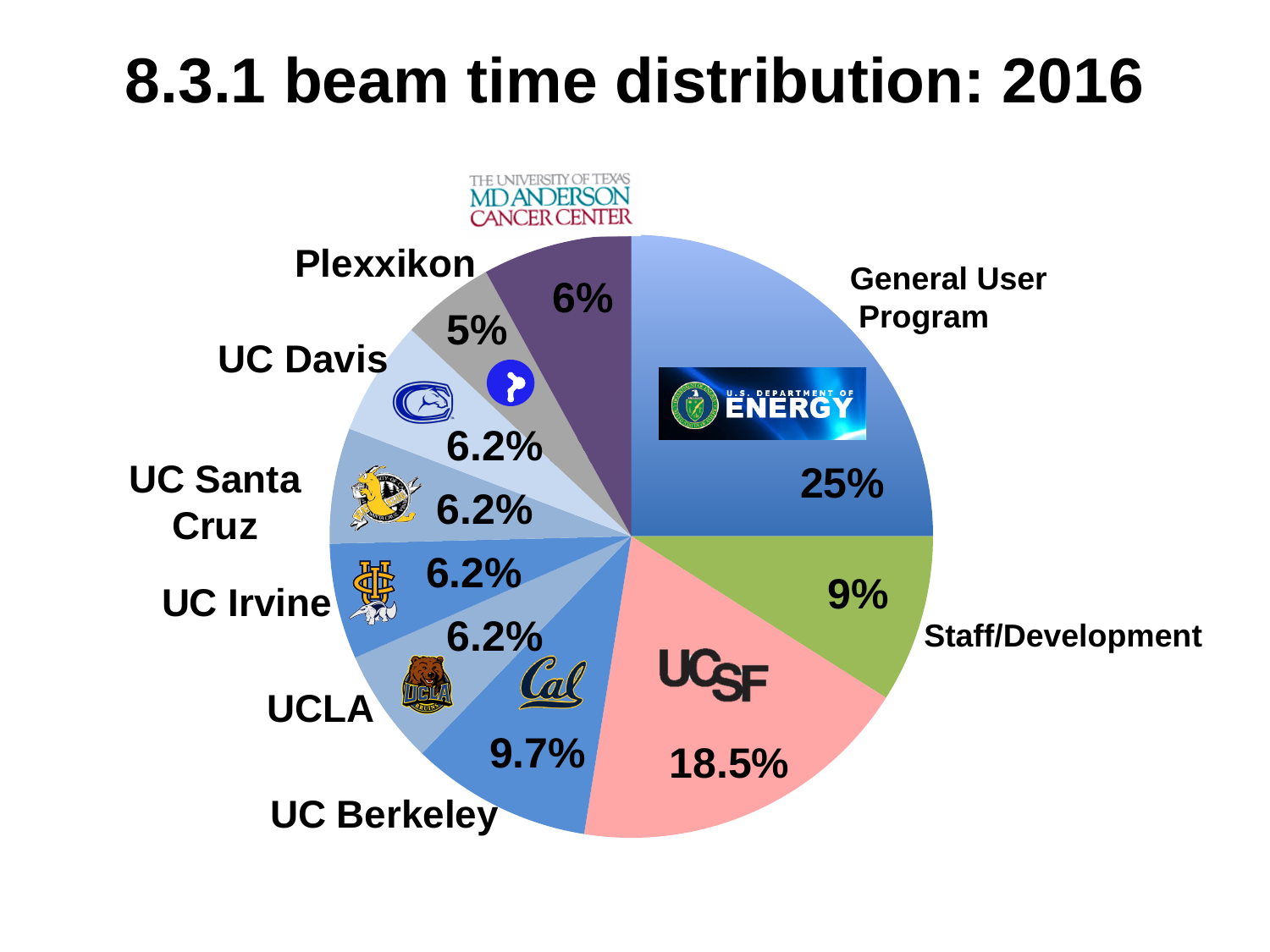
Which slice has the largest share of beam time? General User Program What percentage is shown for UCLA? 6.2% What type of chart is shown on the slide? Pie chart What percentage is shown for Plexxikon? 5% What share of beam time does the General User Program slice show? 25% What percentage is shown for the UCSF slice? 18.5% Which slice has the smallest share of beam time? Plexxikon What percentage is shown for Staff/Development? 9% How many slices does the pie chart have? 10 What percentage of beam time is labelled for UC Berkeley? 9.7% Which is larger, the UC Berkeley share or the Staff/Development share? UC Berkeley How many percentage points larger is the General User Program share than the Staff/Development share? 16%